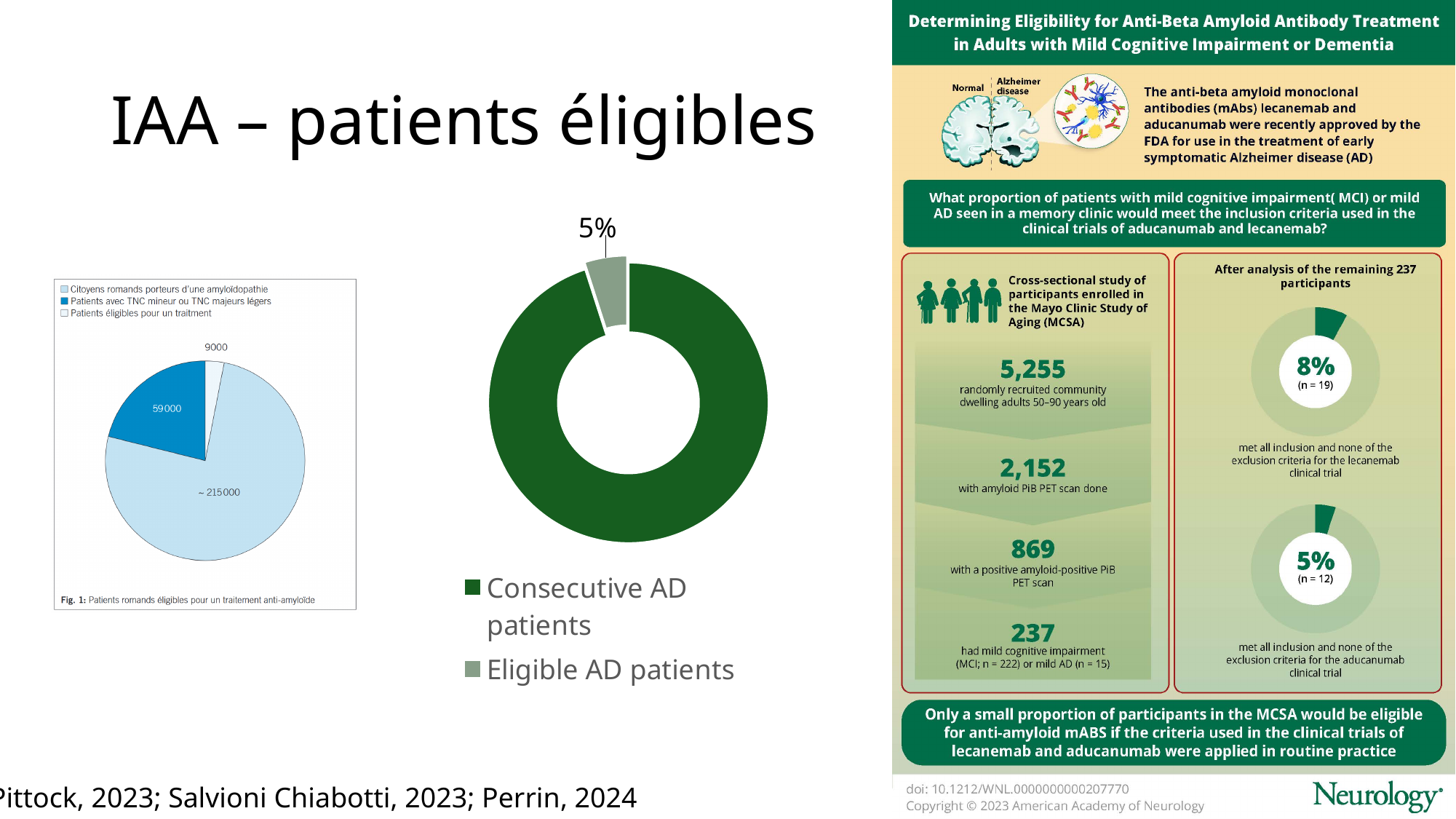
In the middle doughnut chart, what percentage is shown for Eligible AD patients? 5% In the left pie chart (Fig. 1), which category has the smallest slice? Patients éligibles pour un traitement In the right infographic, what is the difference in the number of participants (n) between the lecanemab doughnut (n = 19) and the aducanumab doughnut (n = 12)? 7 In the left pie chart (Fig. 1), which category has the largest slice? Citoyens romands porteurs d'une amyloïdopathie In the left pie chart (Fig. 1), what value is labelled on the white slice for Patients éligibles pour un traitement? 9000 In the left pie chart (Fig. 1), what value is labelled on the dark blue slice? 59000 In the left pie chart (Fig. 1), what is the difference between the 59000 slice and the 9000 slice? 50000 In the middle doughnut chart, which category is larger, Consecutive AD patients or Eligible AD patients? Consecutive AD patients In the right infographic, what percentage of the remaining 237 participants met all inclusion and none of the exclusion criteria for the lecanemab clinical trial? 8% In the left pie chart (Fig. 1), how many slices are there? 3 What kind of chart is the middle chart with the 5% label? Doughnut chart How many entries does the legend of the middle doughnut chart list? 2